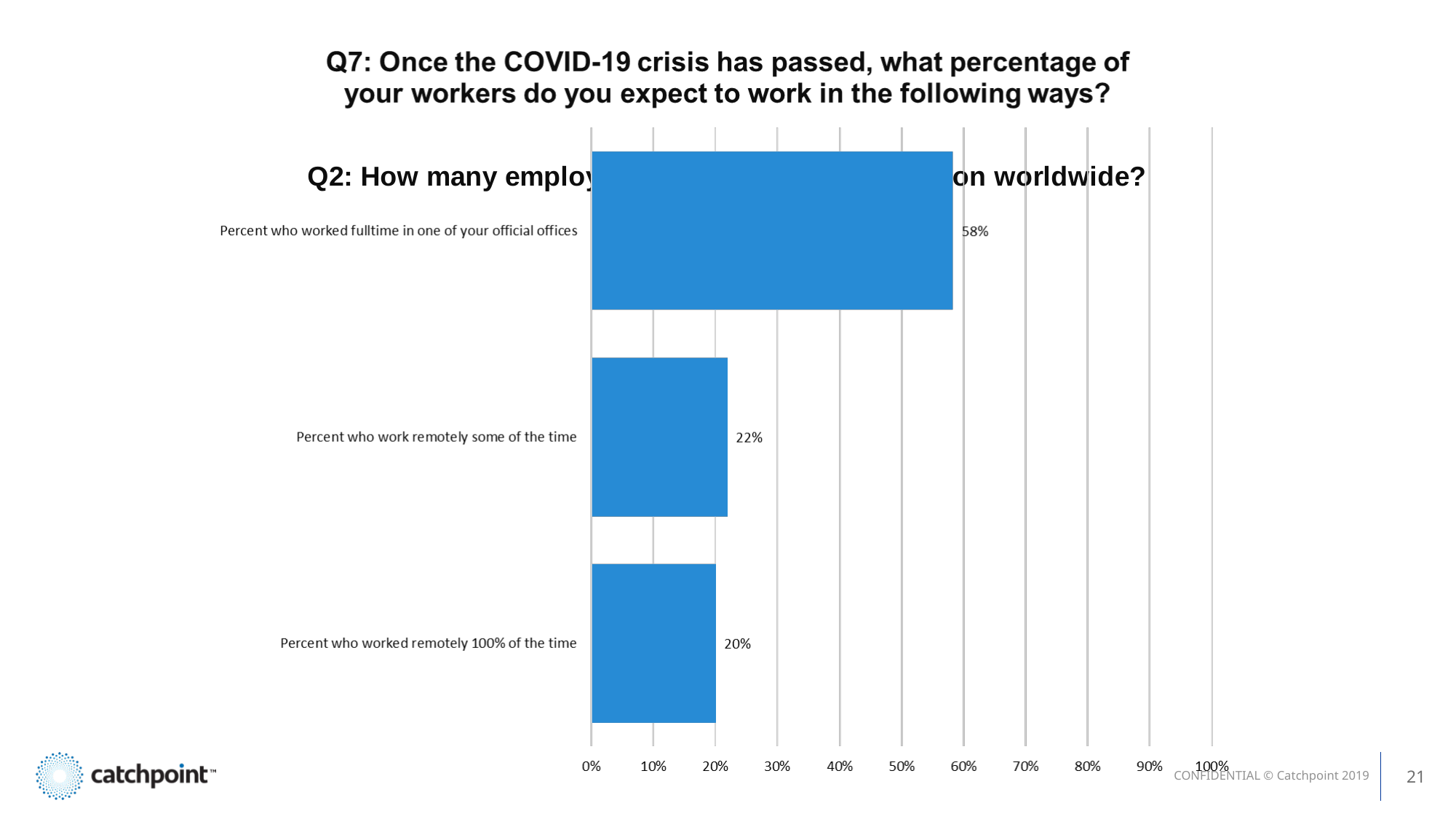
Which is larger: the value for 'Percent who work remotely some of the time' or 'Percent who worked remotely 100% of the time'? Percent who work remotely some of the time Which category has the lowest value? Percent who worked remotely 100% of the time What is the difference between the value for 'Percent who worked fulltime in one of your official offices' and 'Percent who work remotely some of the time'? 36% What is the maximum value shown on the horizontal axis? 100% What percentage is shown for 'Percent who worked remotely 100% of the time'? 20% Which category has the highest value? Percent who worked fulltime in one of your official offices Is the value for 'Percent who worked fulltime in one of your official offices' greater or less than 50%? greater What kind of chart is shown on the slide? Bar chart How many categories are shown in the chart? 3 What percentage is shown for 'Percent who work remotely some of the time'? 22% What percentage is shown for 'Percent who worked fulltime in one of your official offices'? 58% What is the difference between the value for 'Percent who work remotely some of the time' and 'Percent who worked remotely 100% of the time'? 2%